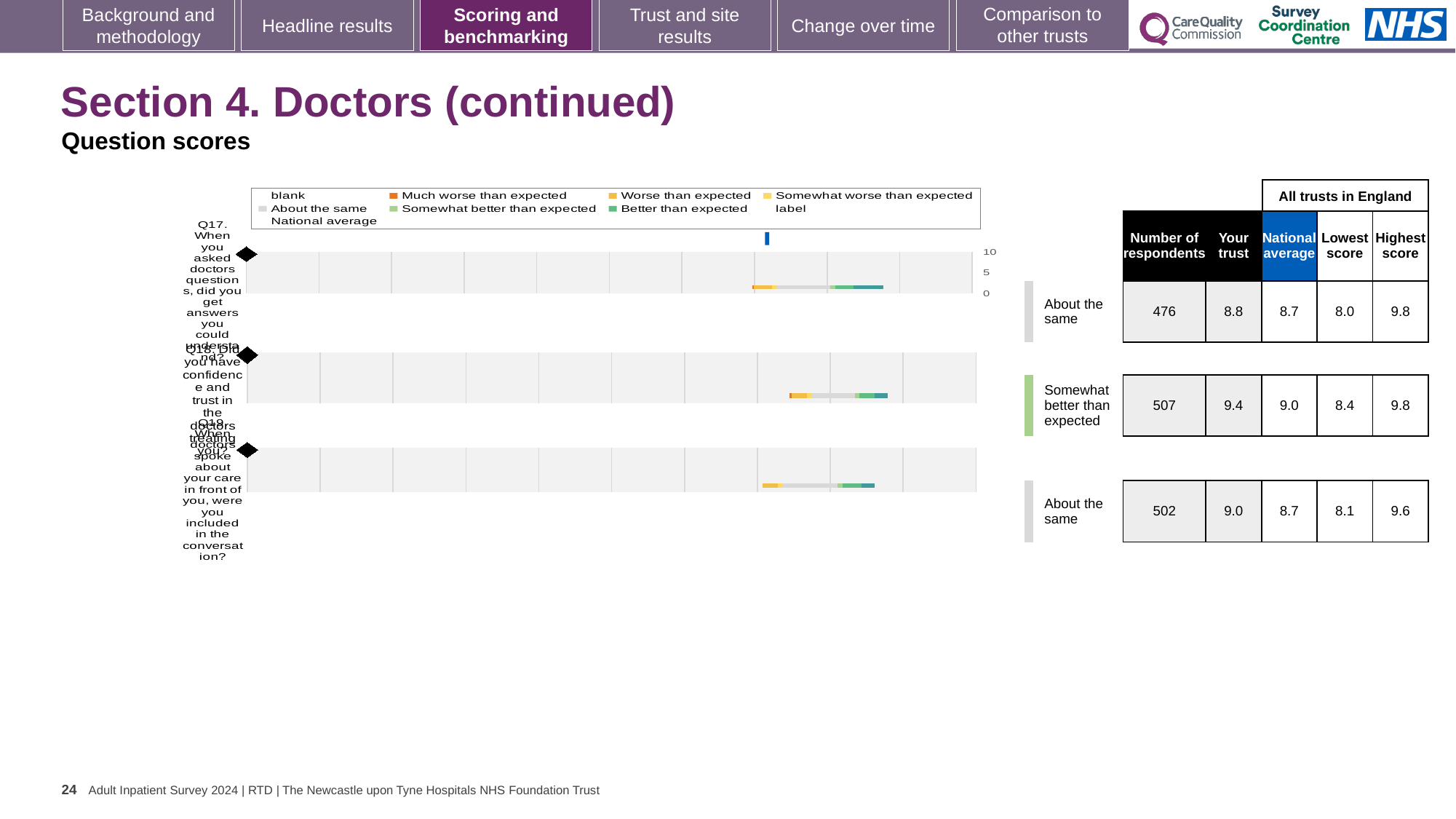
Which question numbers are plotted as categories in the chart? Q17, Q18 and Q19 According to the table beside the chart, what is the number of respondents for the first row (Q17)? 476 How many questions (categories) are plotted in the chart? 3 According to the table beside the chart, what is the 'Your trust' score for the second row (Q18)? 9.4 What is the highest value shown on the chart's axis? 10 What kind of chart is shown on the slide? bar chart According to the table beside the chart, is the 'Your trust' score for the first row (Q17) larger or smaller than the national average? larger According to the table beside the chart, what is the difference between the 'Your trust' score and the national average for the second row (Q18)? 0.4 According to the table beside the chart, what is the national average for the third row (Q19)? 8.7 According to the table beside the chart, which row has the highest 'Your trust' score? Q18 (9.4)